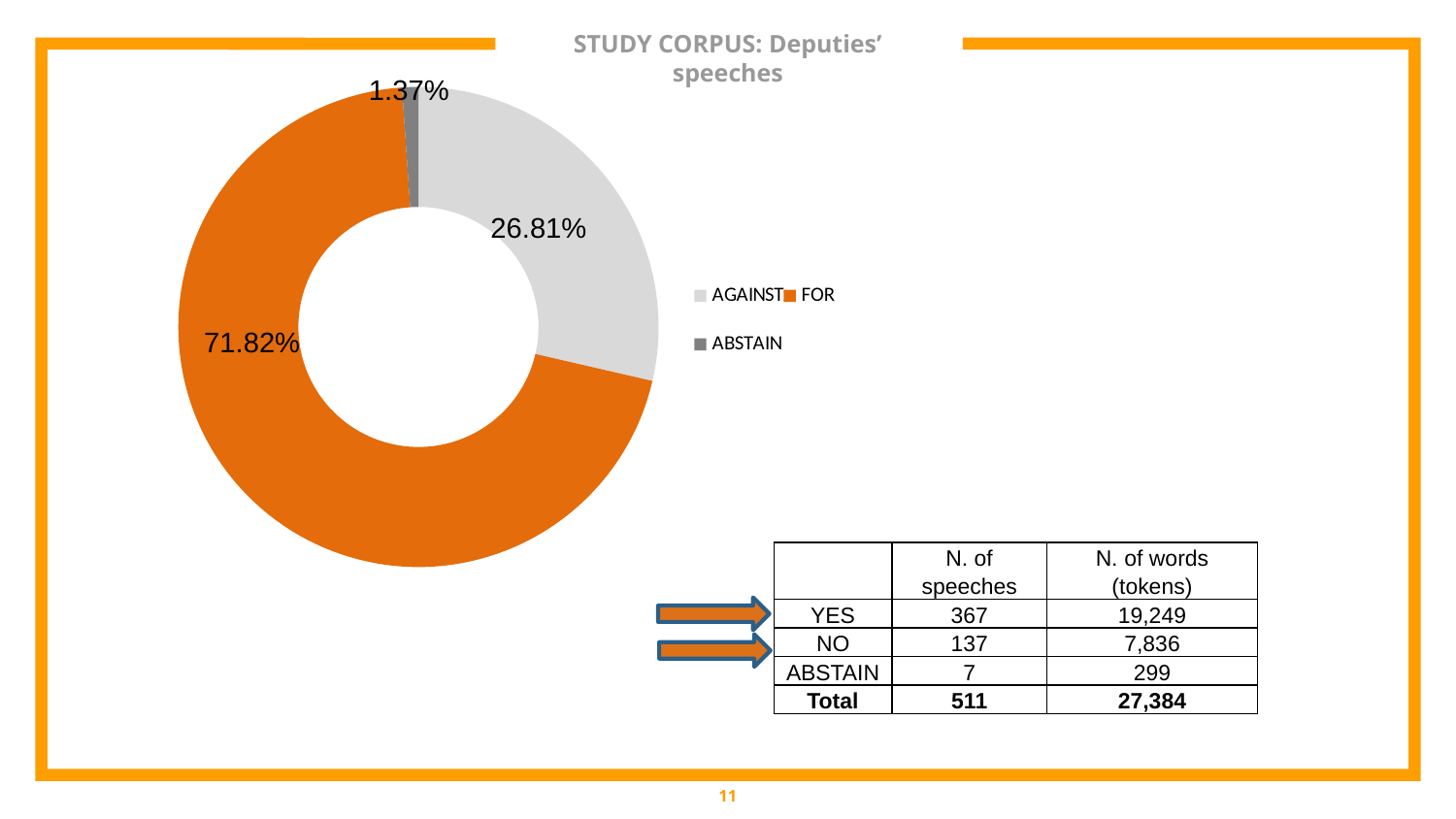
Which category has the smallest slice in the chart? ABSTAIN What is the title of the chart? STUDY CORPUS: Deputies' speeches What share of the chart does the AGAINST slice represent? 26.81% How many entries does the chart legend list? 3 What is the difference in percentage points between the FOR and AGAINST slices? 45.01 Which category has the largest slice in the chart? FOR Which slice is larger, AGAINST or ABSTAIN? AGAINST How many categories does the chart show? 3 What share of the chart does the ABSTAIN slice represent? 1.37% What kind of chart is shown on the slide? Doughnut (pie) chart What share of the chart does the FOR slice represent? 71.82% Which colour represents the FOR category in the chart? Orange